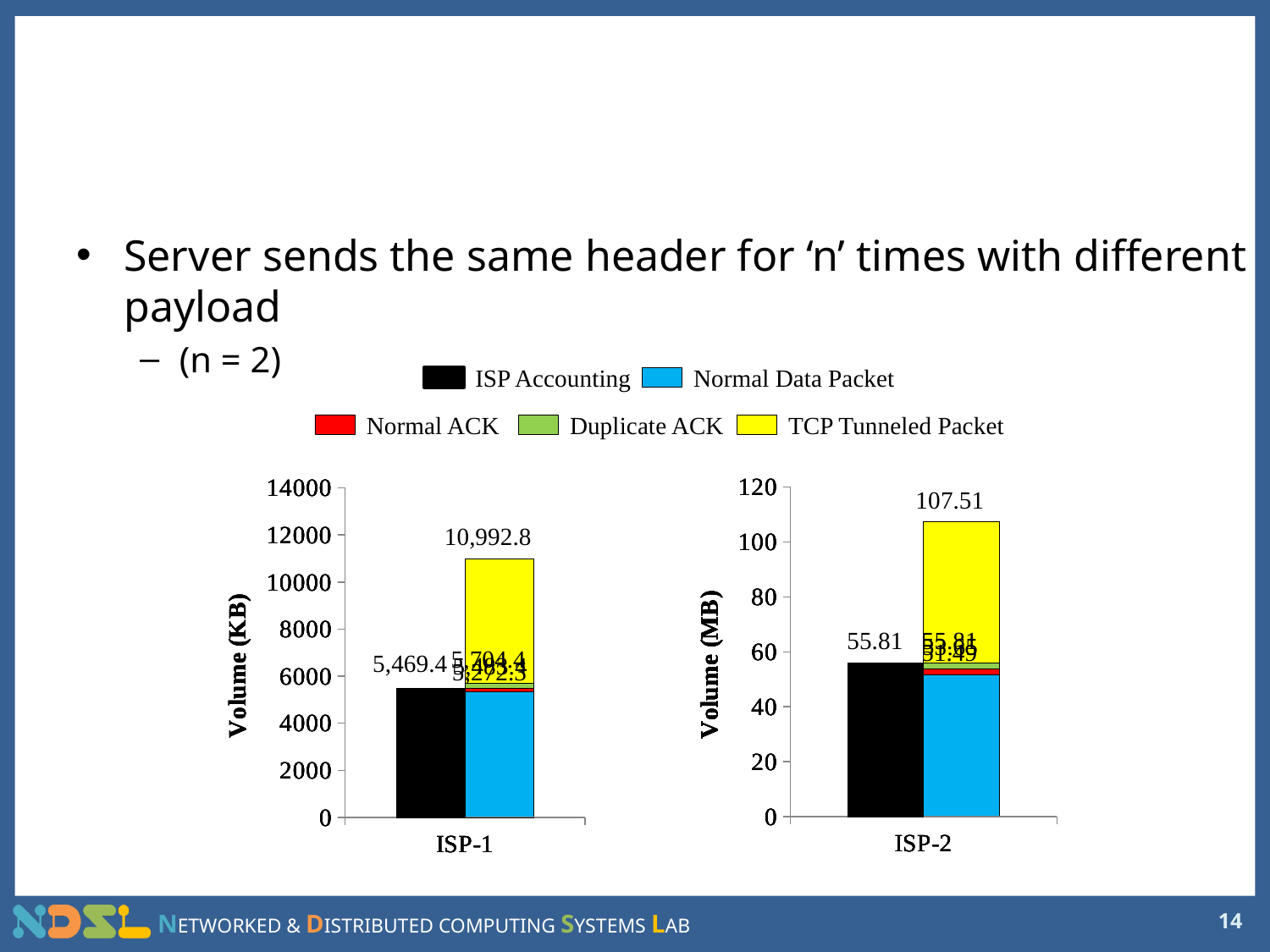
In the ISP-2 chart, what is the value labeled at the top of the TCP Tunneled Packet stacked bar? 107.51 In the ISP-1 chart, what is the difference between the top of the TCP Tunneled Packet stacked bar and the ISP Accounting bar? 5,523.4 In the ISP-2 chart, is the top of the TCP Tunneled Packet stacked bar greater or less than 100? greater In the ISP-2 chart, which is larger: the ISP Accounting bar or the top of the TCP Tunneled Packet stacked bar? TCP Tunneled Packet stacked bar What is the y-axis label of the ISP-2 chart? Volume (MB) In the ISP-1 chart, is the ISP Accounting bar greater or less than 6000? less How many series does the shared legend list? 5 In the ISP-1 chart, what is the value of the ISP Accounting bar? 5,469.4 What kind of chart is the ISP-1 chart? Bar chart In the ISP-1 chart, what is the value labeled at the top of the TCP Tunneled Packet stacked bar? 10,992.8 In the ISP-2 chart, what is the value of the ISP Accounting bar? 55.81 What is the y-axis label of the ISP-1 chart? Volume (KB)